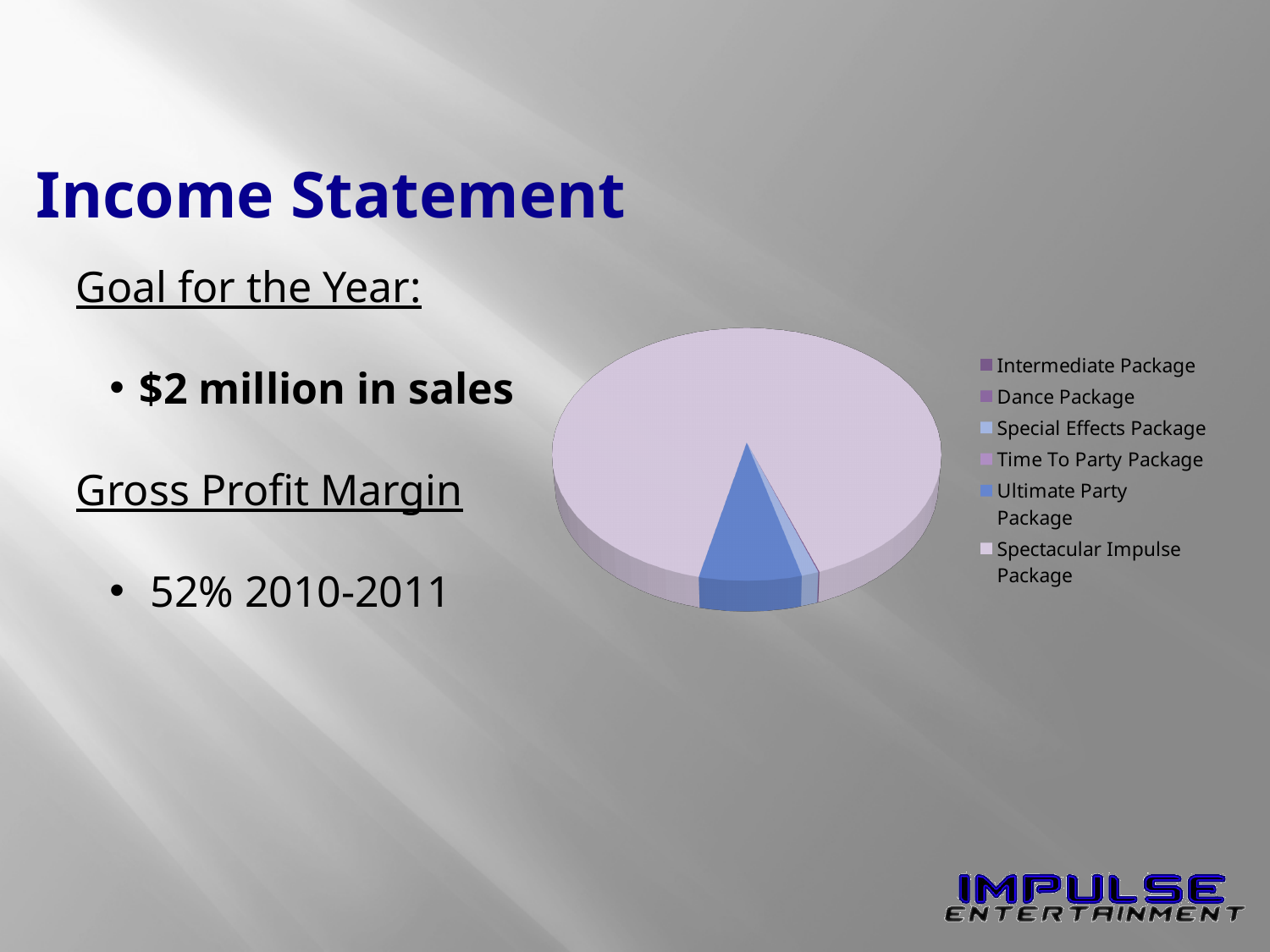
Which legend entry is listed last in the pie chart's legend? Spectacular Impulse Package Does the Ultimate Party Package slice make up more or less than half of the pie? less Which legend entry is listed first in the pie chart's legend? Intermediate Package Which slice is larger, Ultimate Party Package or Special Effects Package? Ultimate Party Package Does the pie chart display data labels with values on its slices? No What kind of chart is shown on the slide? pie chart How many entries does the chart's legend list? 6